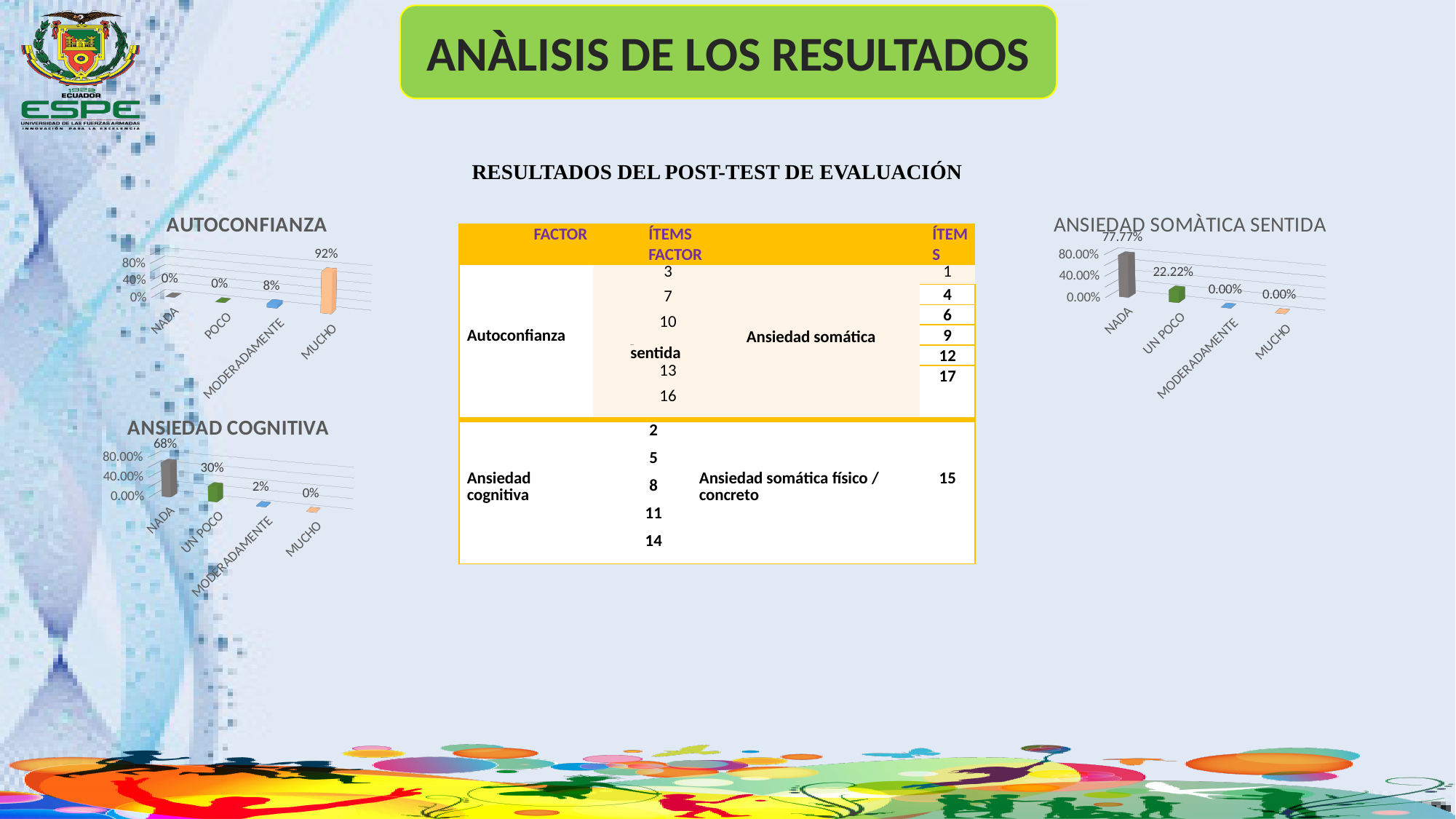
In the AUTOCONFIANZA chart, what is the difference between MUCHO and MODERADAMENTE? 84% In the ANSIEDAD SOMÀTICA SENTIDA chart, what is the value for NADA? 77.77% How many categories does the ANSIEDAD SOMÀTICA SENTIDA chart show? 4 In the AUTOCONFIANZA chart, what is the value for MODERADAMENTE? 8% What kind of chart is the ANSIEDAD COGNITIVA chart? Bar chart In the ANSIEDAD COGNITIVA chart, which is larger, NADA or UN POCO? NADA In the AUTOCONFIANZA chart, which category has the highest value? MUCHO In the ANSIEDAD SOMÀTICA SENTIDA chart, what is the value for UN POCO? 22.22% In the ANSIEDAD COGNITIVA chart, what is the value for UN POCO? 30% In the ANSIEDAD COGNITIVA chart, what is the value for NADA? 68% In the ANSIEDAD COGNITIVA chart, which category has the lowest value? MUCHO In the AUTOCONFIANZA chart, what is the value for MUCHO? 92%